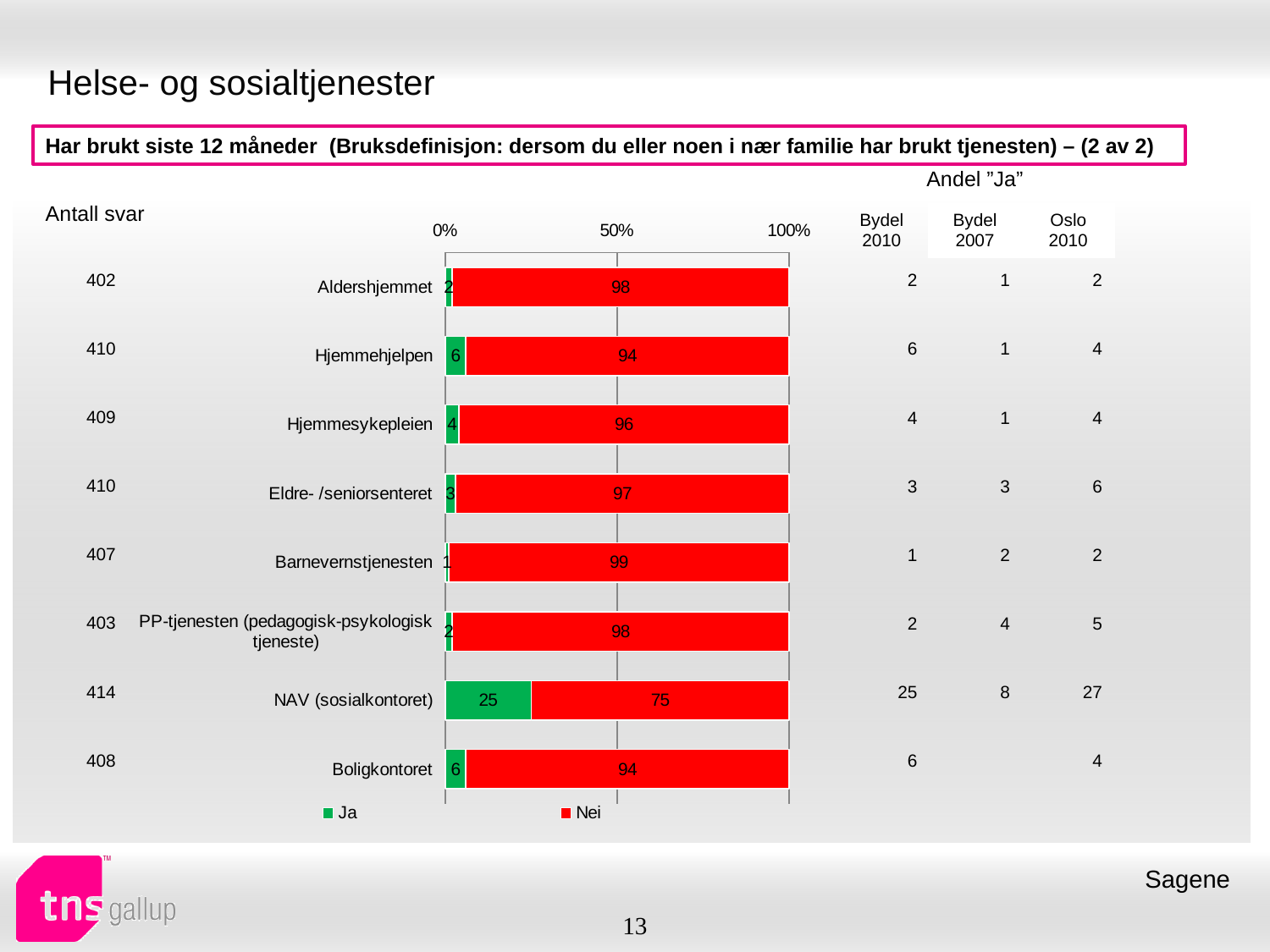
What is the "Nei" value for Barnevernstjenesten? 99 How many series does the chart legend list? 2 What is the difference between the "Nei" values for Barnevernstjenesten and NAV (sosialkontoret)? 24 What is the "Ja" value for NAV (sosialkontoret)? 25 What is the "Ja" value for Boligkontoret? 6 Which category has the highest "Ja" value? NAV (sosialkontoret) How many categories (services) are plotted in the chart? 8 What is the "Nei" value for Aldershjemmet? 98 Which is larger, the "Ja" value for Hjemmehjelpen or the "Ja" value for Hjemmesykepleien? Hjemmehjelpen Which colour represents the "Nei" series in the chart? red What kind of chart is shown on the slide? bar chart Which category has the lowest "Nei" value? NAV (sosialkontoret)